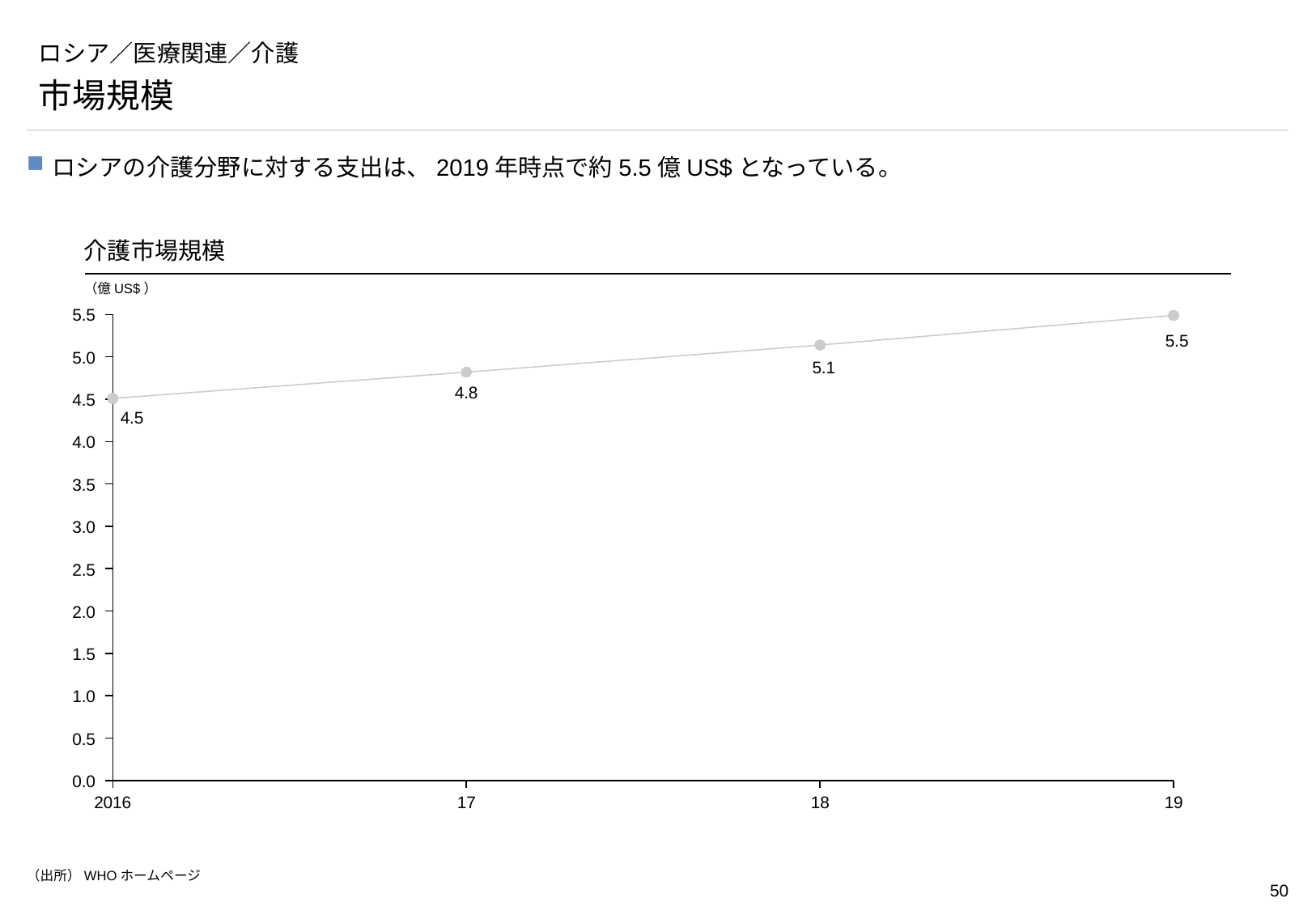
What is the value for 2016? 4.5 How many data points are plotted? 4 What is the value for 18? 5.1 Which year has the lowest value? 2016 Which year has the highest value? 19 Which is larger, the value for 17 or the value for 18? 18 What kind of chart is this? line chart Is the value for 2016 greater or less than 4.0? greater Do the values rise or fall from 2016 to 19? rise What is the value for 19? 5.5 What is the difference between the values for 19 and 2016? 1.0 What is the value for 17? 4.8